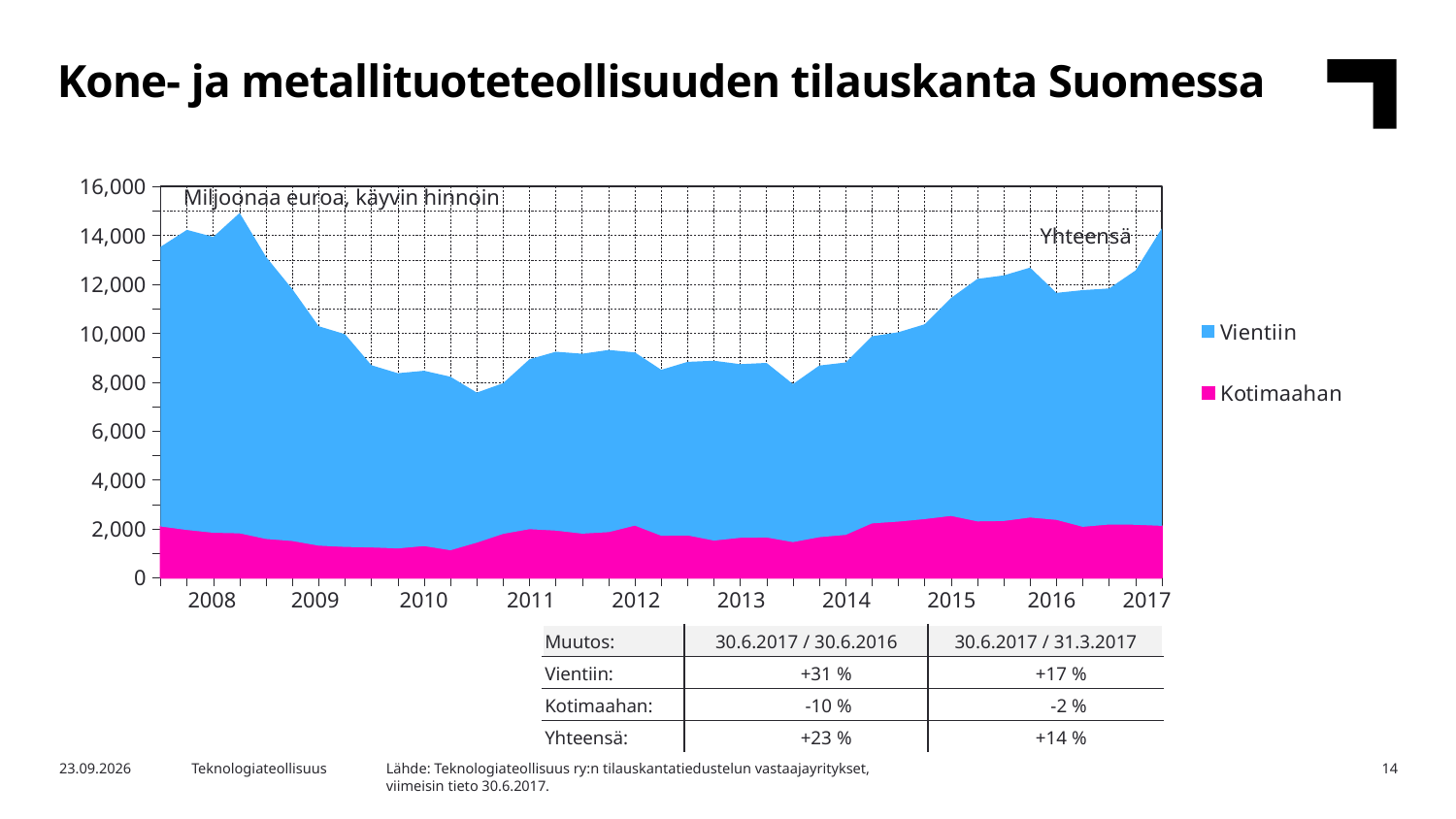
Which series occupies the larger area of the chart, Vientiin or Kotimaahan? Vientiin Is the total (Yhteensä) value at the end of 2017 greater or less than 12,000? greater Is the total (Yhteensä) value at the start of 2008 greater or less than 12,000? greater Is the Kotimaahan value in 2010 greater or less than 2,000? less Does the total order backlog rise or fall between 2014 and 2017? rise How many series does the chart legend list? 2 What unit is stated in the chart's subtitle? Miljoonaa euroa, käyvin hinnoin Does the total order backlog rise or fall between 2008 and 2010? fall What kind of chart is shown on the slide? Stacked area chart How many year labels are shown on the x axis? 10 What are the two series named in the chart legend? Vientiin and Kotimaahan